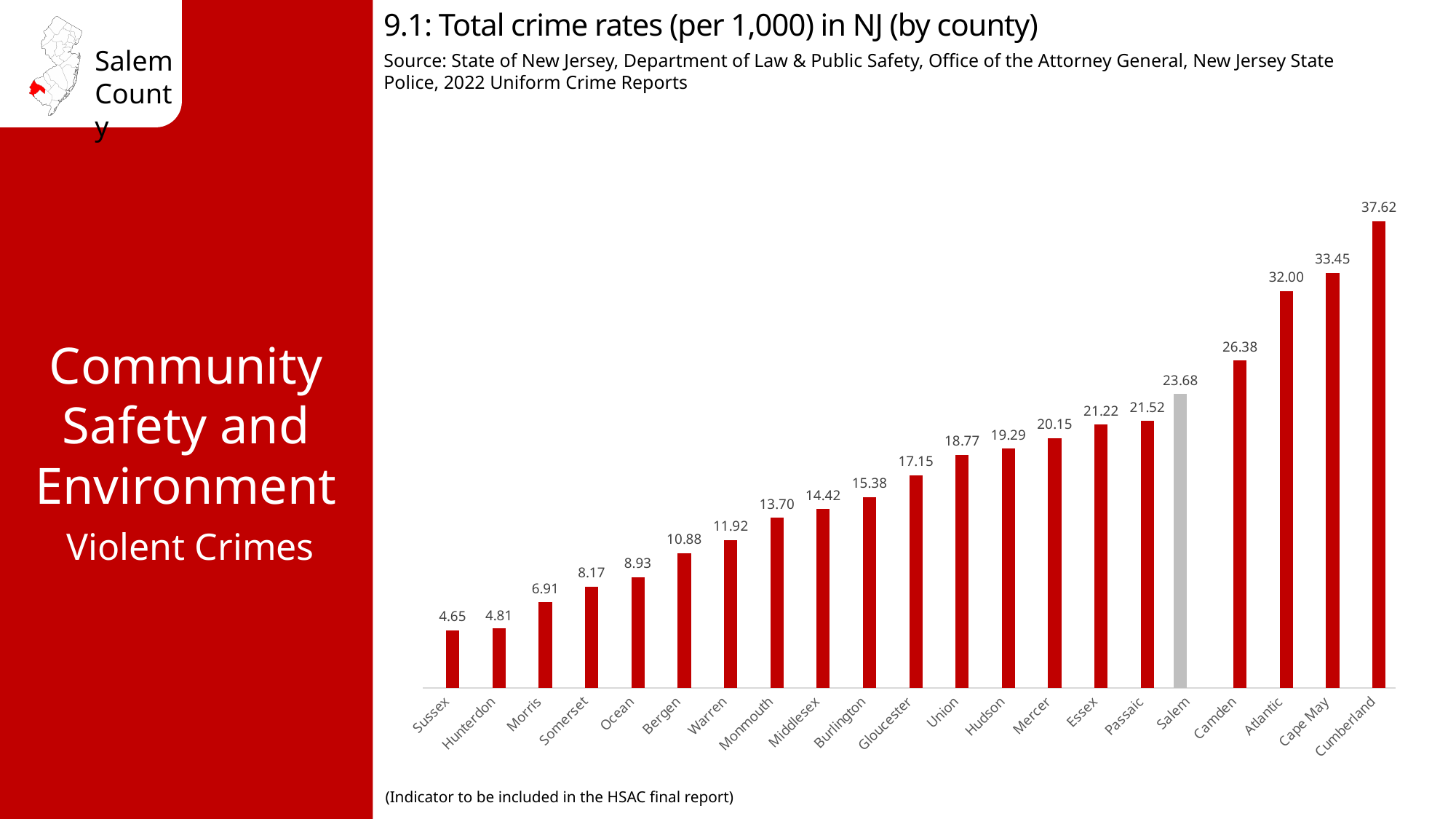
Which county has a higher total crime rate, Morris or Ocean? Ocean Which county's bar is shown in grey rather than red? Salem Which county has a higher total crime rate, Camden or Salem? Camden Which county has the highest total crime rate? Cumberland What is the total crime rate (per 1,000) for Bergen County? 10.88 What is the difference between the total crime rates of Salem and Passaic? 2.16 What is the total crime rate (per 1,000) for Gloucester County? 17.15 How many counties are shown in the chart? 21 What kind of chart is used to show the total crime rates by county? Bar chart What is the difference between the total crime rates of Cumberland and Sussex? 32.97 What is the total crime rate (per 1,000) for Salem County? 23.68 Which county has the lowest total crime rate? Sussex